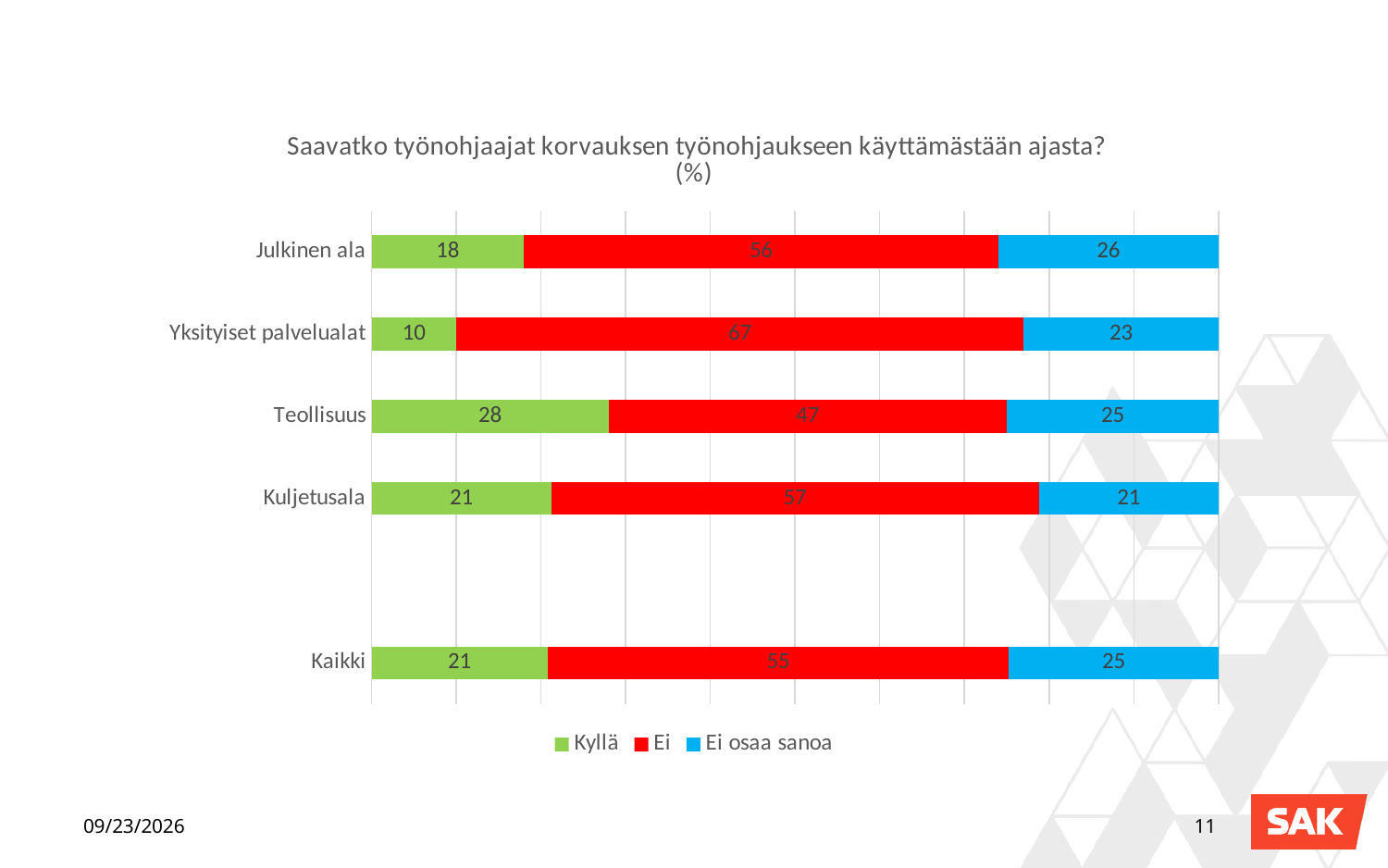
Which category has the highest "Kyllä" value? Teollisuus How many categories are shown on the chart? 5 What is the total of the stacked bar for Kuljetusala? 99 What is the value of "Ei" for Yksityiset palvelualat? 67 What is the value of "Kyllä" for Teollisuus? 28 What is the difference between the "Ei" values for Yksityiset palvelualat and Teollisuus? 20 What kind of chart is shown on the slide? Stacked bar chart Which category has the lowest "Kyllä" value? Yksityiset palvelualat Which legend entry is shown in red? Ei How many series does the legend list? 3 What is the value of "Ei osaa sanoa" for Julkinen ala? 26 Which is larger: the "Ei osaa sanoa" value for Julkinen ala or for Kuljetusala? Julkinen ala